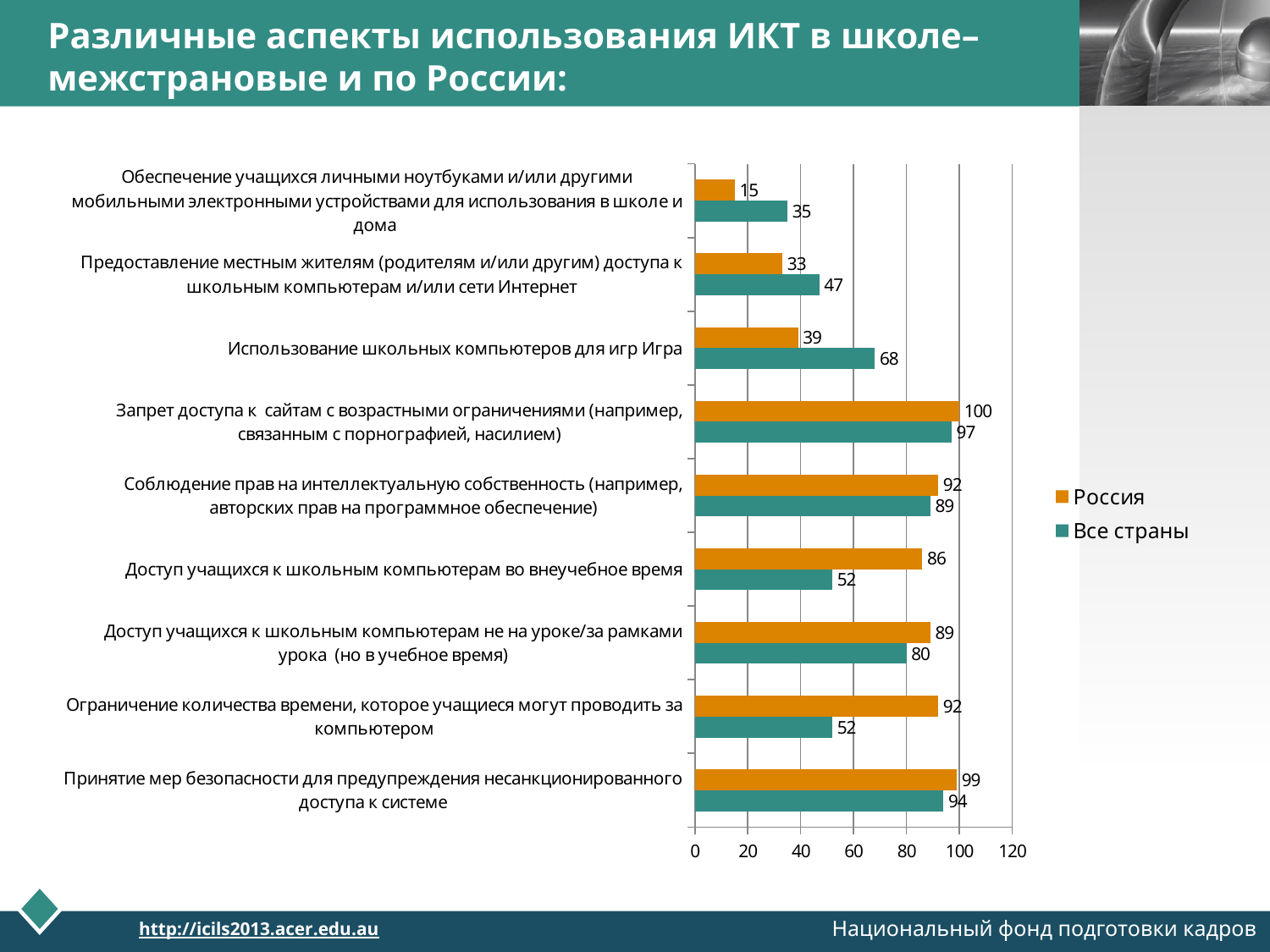
What is the value for Россия for «Использование школьных компьютеров для игр»? 39 What is the value for Все страны for «Ограничение количества времени, которое учащиеся могут проводить за компьютером»? 52 What kind of chart is shown on the slide? bar chart How many categories are shown on the chart? 9 Which category has the highest value for Россия? Запрет доступа к сайтам с возрастными ограничениями (например, связанным с порнографией, насилием) Which category has the lowest value for Все страны? Обеспечение учащихся личными ноутбуками и/или другими мобильными электронными устройствами для использования в школе и дома What is the value for Все страны for «Обеспечение учащихся личными ноутбуками и/или другими мобильными электронными устройствами для использования в школе и дома»? 35 Which series is shown in orange in the legend? Россия How many series does the legend list? 2 What is the difference between the Россия and Все страны values for «Доступ учащихся к школьным компьютерам во внеучебное время»? 34 For «Использование школьных компьютеров для игр», which series has the larger value, Россия or Все страны? Все страны Is the Россия value for «Предоставление местным жителям (родителям и/или другим) доступа к школьным компьютерам и/или сети Интернет» greater or less than 40? less